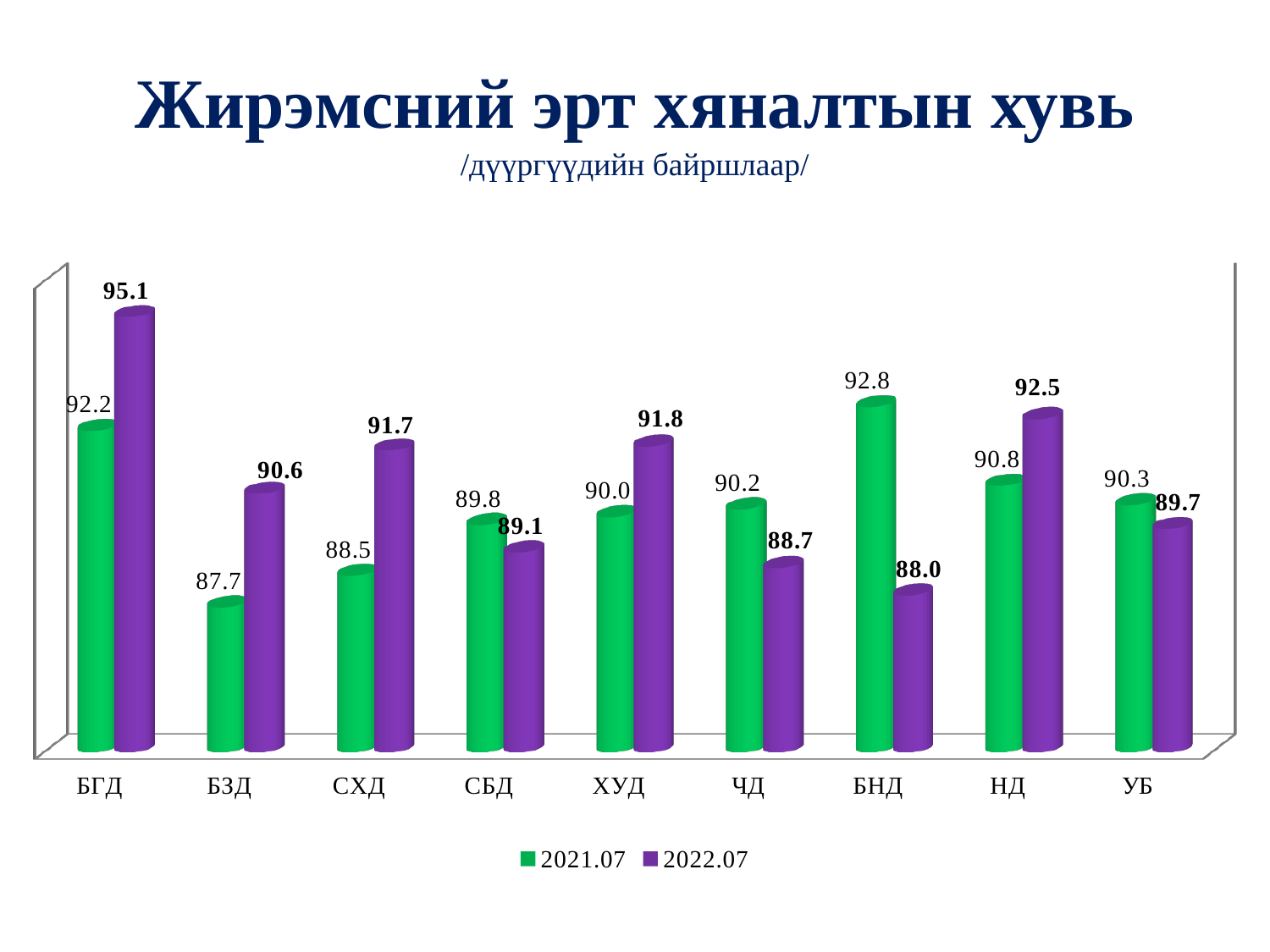
Which category has the lowest 2021.07 value? БЗД How many categories are shown on the x axis? 9 What is the 2021.07 value for БНД? 92.8 Which category has the highest 2022.07 value? БГД Which is larger for БНД, the 2021.07 value or the 2022.07 value? 2021.07 Which category has the lowest 2022.07 value? БНД What is the 2022.07 value for БГД? 95.1 What is the difference between the 2022.07 and 2021.07 values for БЗД? 2.9 How many series does the legend list? 2 What kind of chart is shown on the slide? Bar chart Which colour represents the 2022.07 series? Purple What is the 2022.07 value for ЧД? 88.7